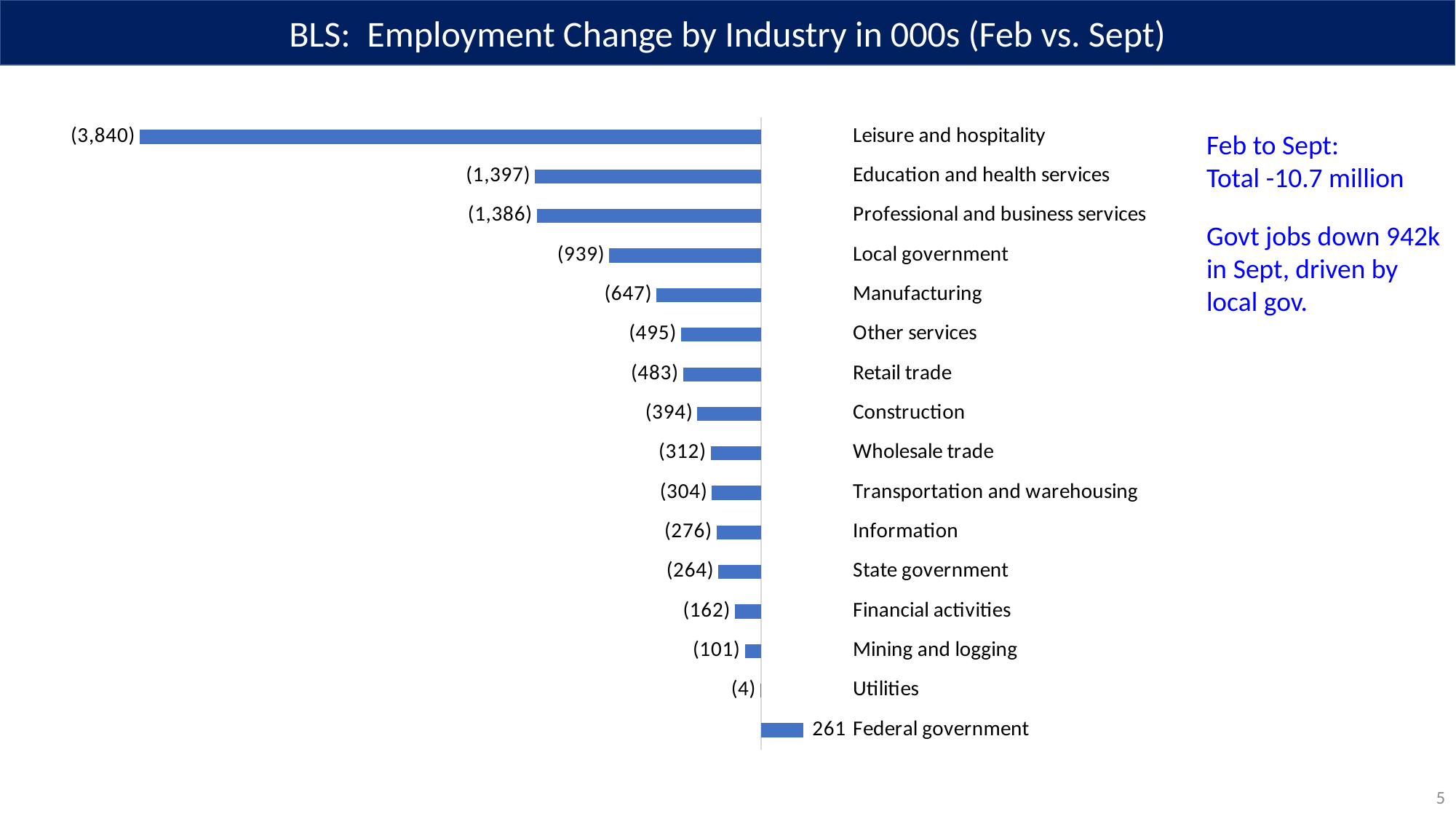
What is the employment change shown for Leisure and hospitality? (3,840) Which industry is the only one with a positive employment change? Federal government What type of chart is shown on the slide? Bar chart Which industry shows the largest decline in employment? Leisure and hospitality How many industries are shown in the chart? 16 What is the title of the chart? BLS: Employment Change by Industry in 000s (Feb vs. Sept) What is the value labeled for Federal government? 261 By how much does the decline for Local government exceed the decline for State government? 675 What value is shown for Utilities? (4) What is the difference between the values for Education and health services and Professional and business services? 11 Which industry has a larger decline, Manufacturing or Construction? Manufacturing What value is shown for Local government? (939)